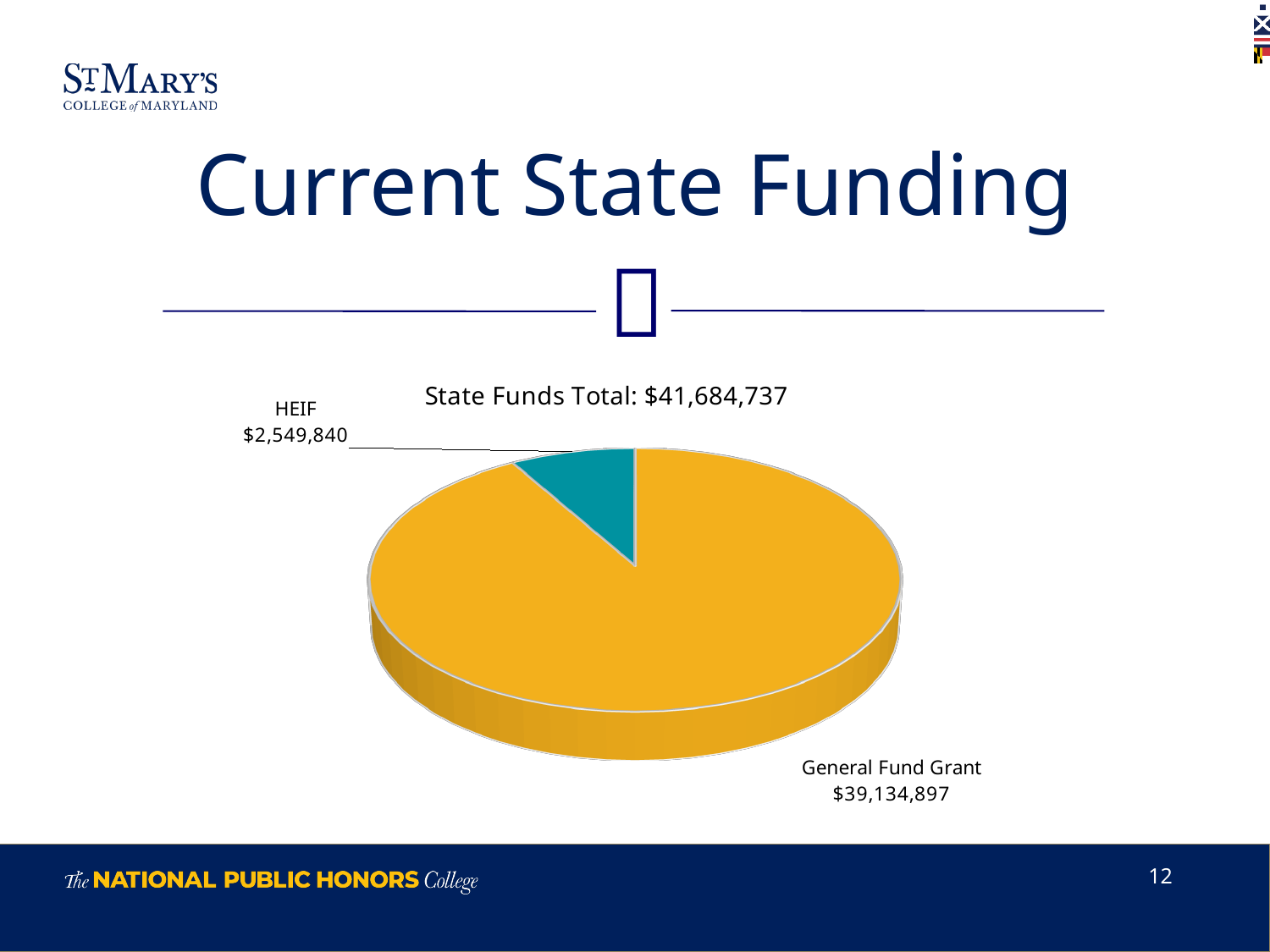
What is the title of the pie chart? State Funds Total: $41,684,737 What is the total of state funds shown in the chart title? $41,684,737 Which is larger, HEIF or General Fund Grant? General Fund Grant What colour is the HEIF slice? Teal Which slice of the pie is the smallest? HEIF What type of chart is shown on the slide? Pie chart How many slices does the pie chart have? 2 Which slice of the pie is the largest? General Fund Grant To the nearest whole percent, what share of the state funds total does HEIF represent? 6% What is the value of the General Fund Grant slice? $39,134,897 What is the value of the HEIF slice? $2,549,840 What is the difference between the General Fund Grant and HEIF values? $36,585,057